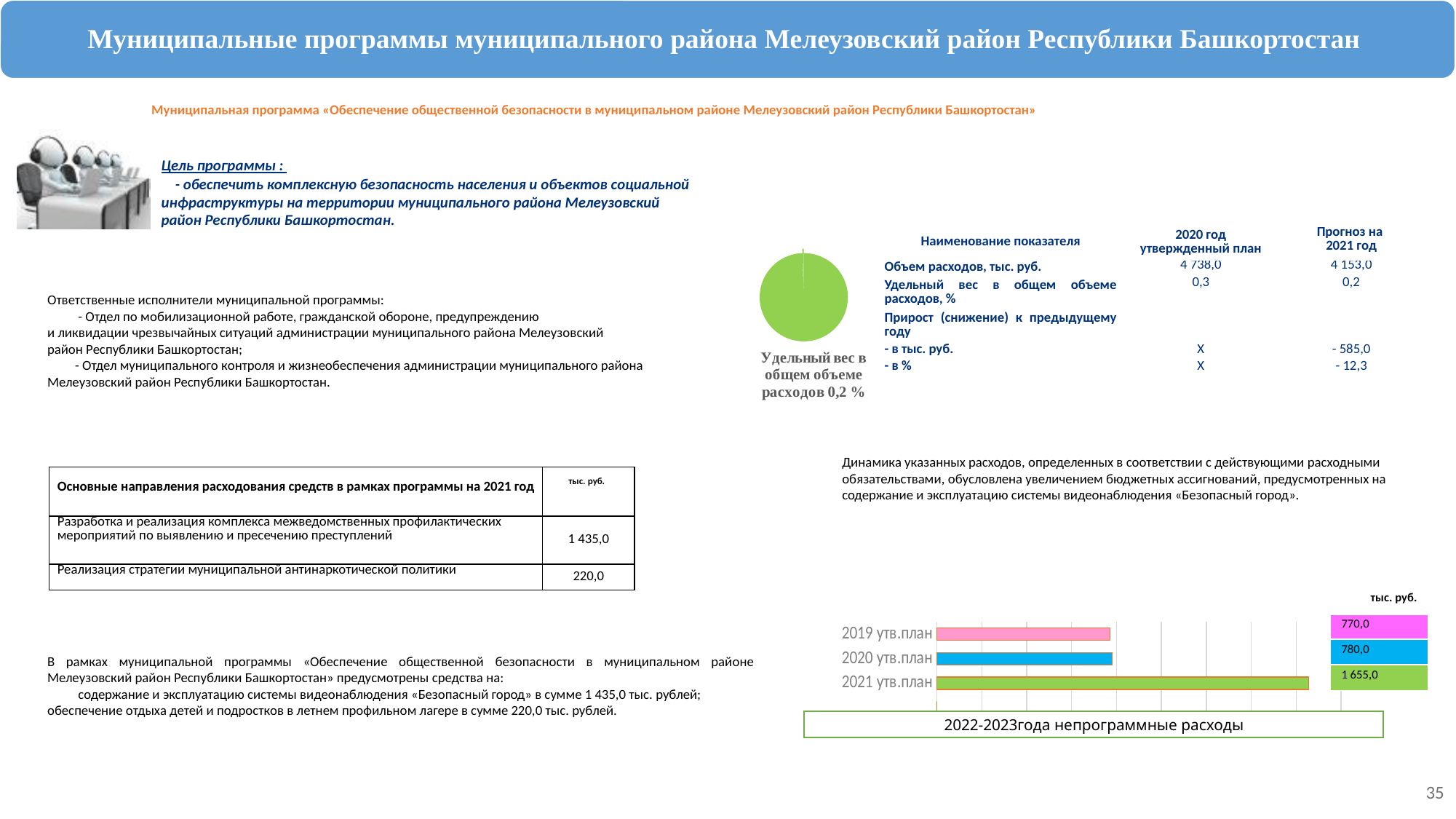
How many bars are plotted in the bottom-right bar chart? 3 In the bottom-right bar chart, which year has the highest value? 2021 утв.план In the bottom-right bar chart, what is the difference between the values for 2021 утв.план and 2019 утв.план? 885,0 According to the pie chart labelled «Удельный вес в общем объеме расходов», what share of total expenditure does the program represent? 0,2 % What kind of chart is the green chart in the upper middle of the slide labelled «Удельный вес в общем объеме расходов»? pie chart In the bottom-right bar chart, what is the value for 2020 утв.план? 780,0 In the bottom-right bar chart, what is the value for 2021 утв.план? 1 655,0 In the bottom-right bar chart, what is the value for 2019 утв.план? 770,0 In the bottom-right bar chart, which is larger: the value for 2021 утв.план or the value for 2019 утв.план? 2021 утв.план In the bottom-right bar chart, what is the difference between the values for 2021 утв.план and 2020 утв.план? 875,0 In the bottom-right bar chart, do the values rise or fall from 2019 to 2021? rise What kind of chart is the chart at the bottom right of the slide showing 2019, 2020 and 2021 утв.план? bar chart